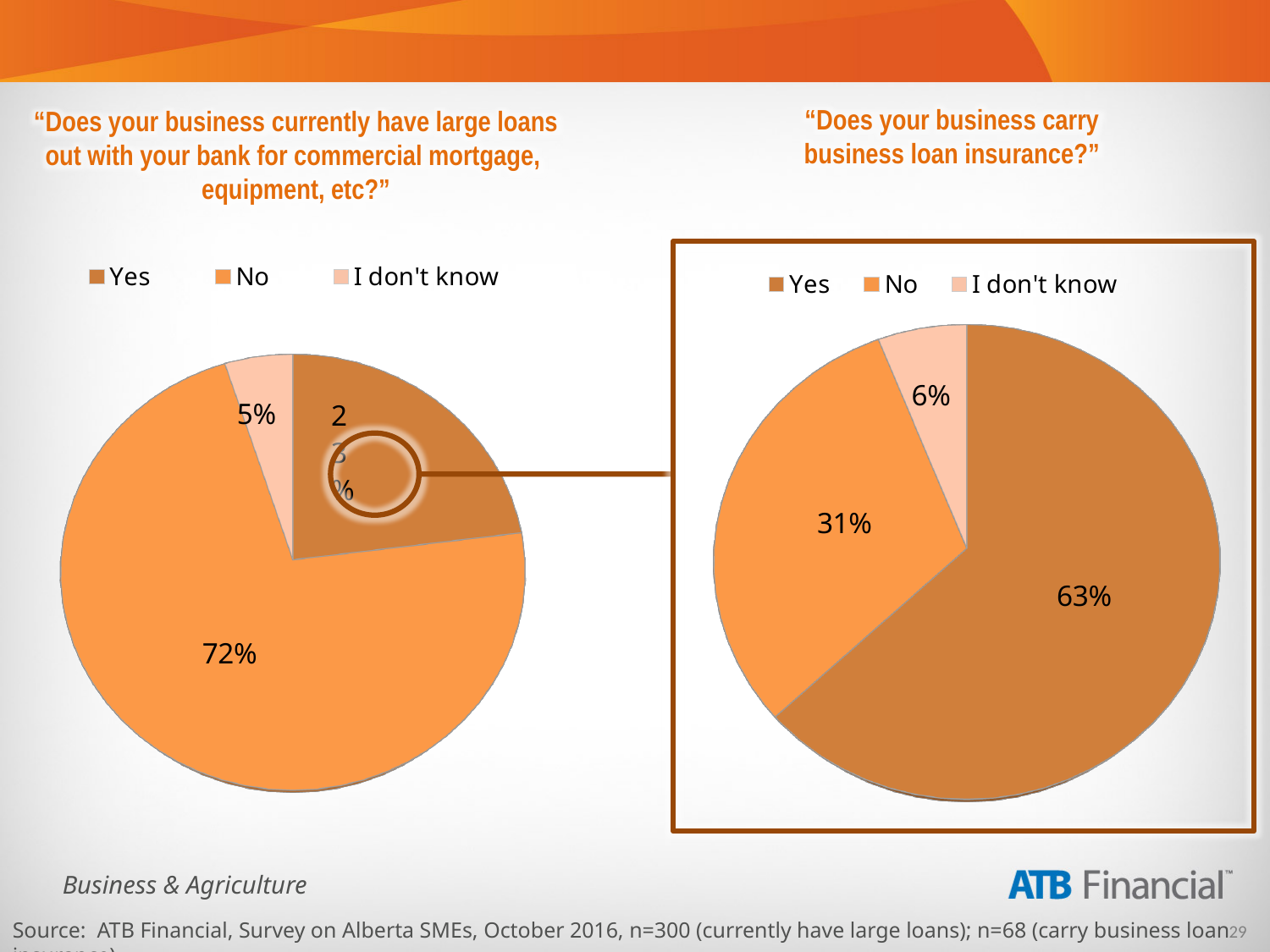
In the right-hand chart about business loan insurance, which response has the largest slice? Yes In the right-hand chart about business loan insurance, which response has the smallest slice? I don't know In the right-hand chart about business loan insurance, how many percentage points higher is Yes than No? 32 percentage points What kind of chart is used for the business loan insurance question? Pie chart In the chart titled "Does your business carry business loan insurance?", what percentage answered I don't know? 6% In the chart titled "Does your business carry business loan insurance?", what percentage answered No? 31% How many entries does the legend of the right-hand chart about business loan insurance list? 3 In the chart titled "Does your business currently have large loans out with your bank for commercial mortgage, equipment, etc?", what percentage answered I don't know? 5% In the left-hand chart about large loans, how many percentage points higher is No than I don't know? 67 percentage points In the chart titled "Does your business carry business loan insurance?", what percentage answered Yes? 63% In the left-hand chart about large loans, which response has the largest slice? No In the chart titled "Does your business currently have large loans out with your bank for commercial mortgage, equipment, etc?", what percentage answered No? 72%